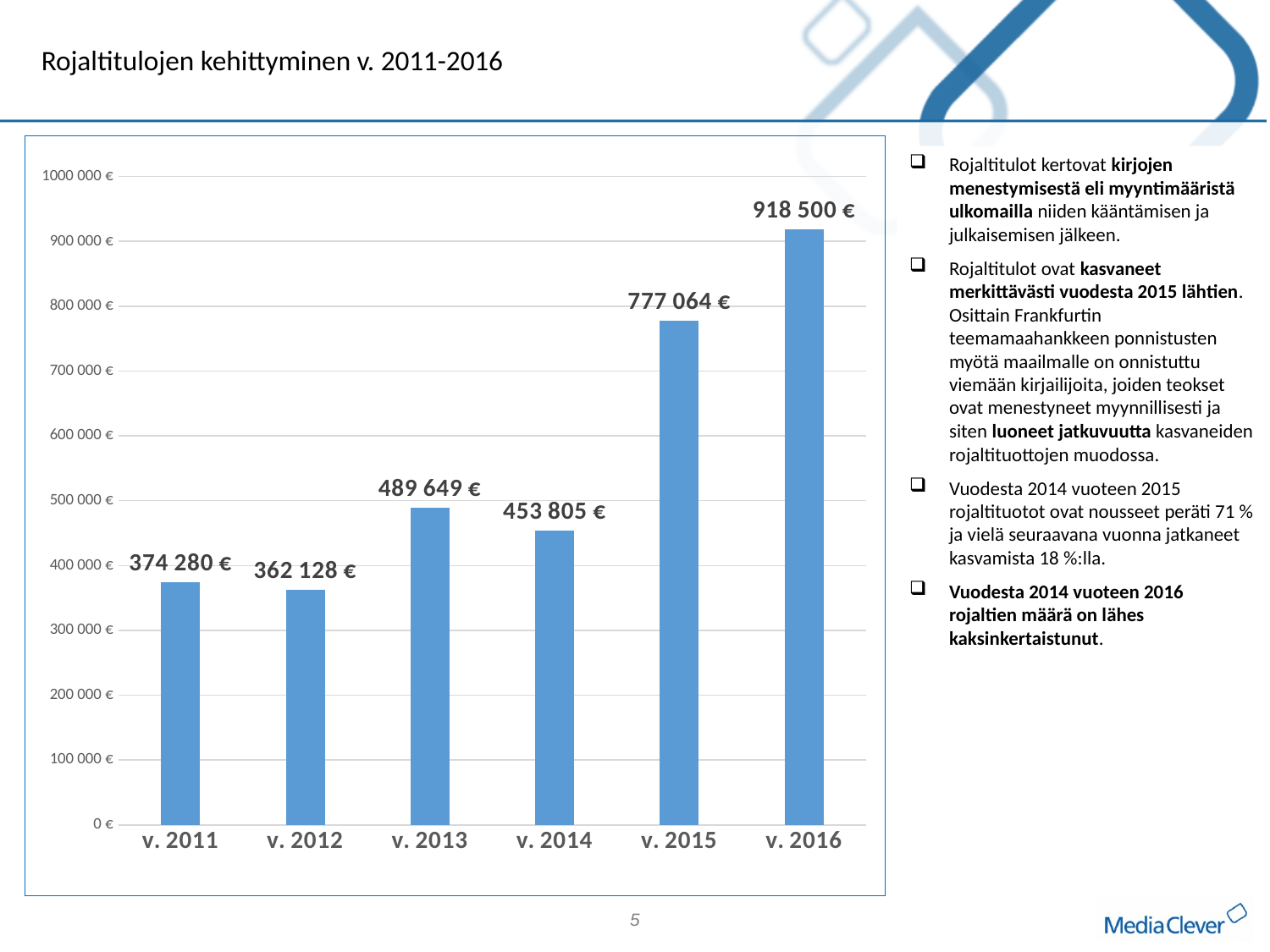
Which year has the highest value in the chart? v. 2016 What is the royalty income value shown for v. 2016? 918 500 € What is the difference between the values for v. 2016 and v. 2015? 141 436 € Is the value for v. 2015 greater or less than 700 000 €? greater Which is larger, the value for v. 2013 or the value for v. 2014? v. 2013 What is the difference between the values for v. 2013 and v. 2014? 35 844 € What value is shown for v. 2013? 489 649 € Which year has the lowest value in the chart? v. 2012 What kind of chart is shown on the slide? bar chart Do the values generally rise or fall from v. 2014 to v. 2016? rise What value is shown for v. 2012? 362 128 € How many years (bars) are shown in the chart? 6